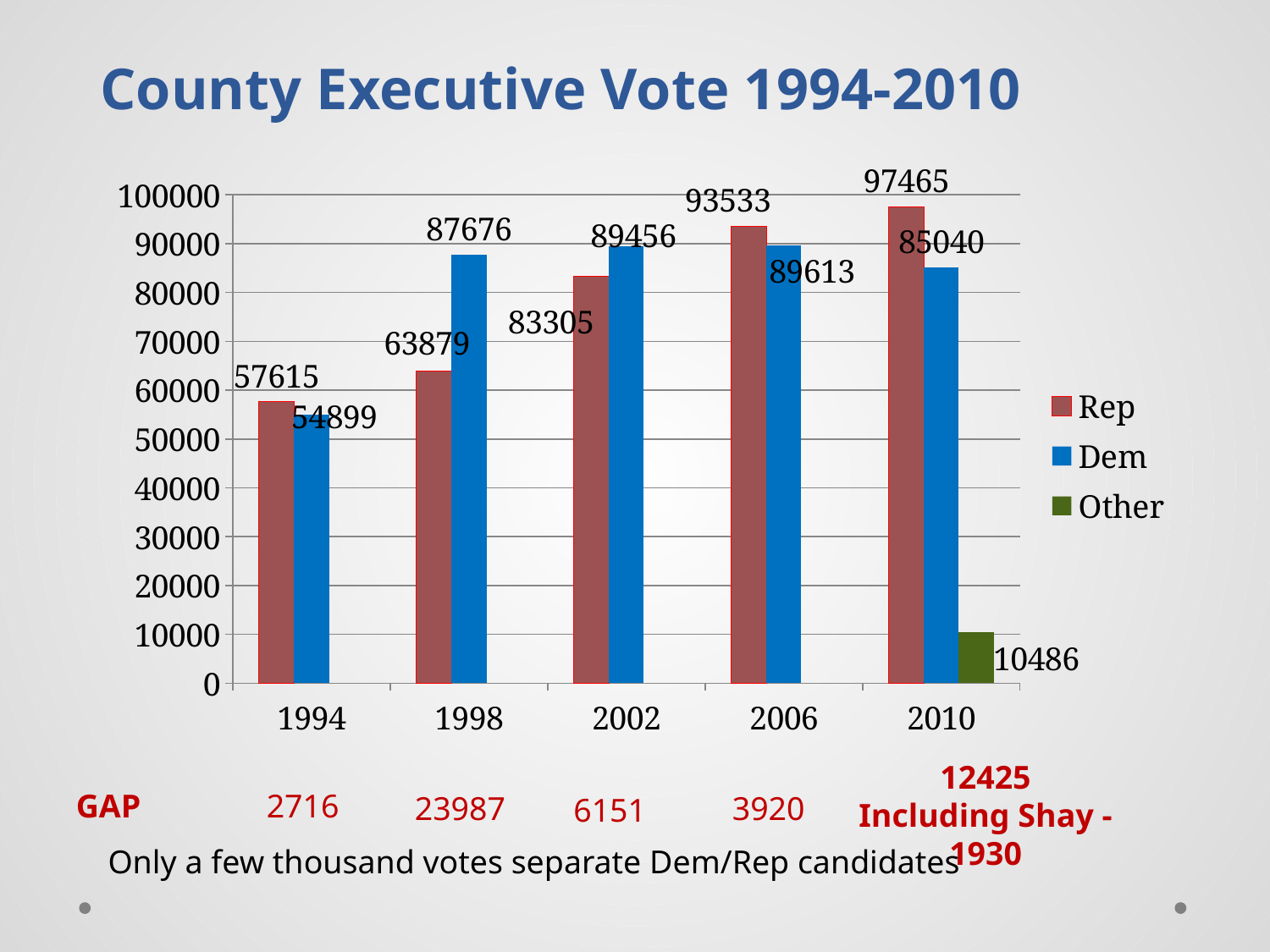
What is the Dem value for 1998? 87676 Which is larger in 1998, the Rep value or the Dem value? Dem What is the Rep value for 2010? 97465 In which year is the Rep value highest? 2010 How many years are shown on the x axis? 5 Do the Rep values rise or fall from 1994 to 2010? rise In which year is the Dem value lowest? 1994 What is the Other value for 2010? 10486 What is the difference between the Rep and Dem values in 2010? 12425 How many series does the legend list? 3 What is the difference between the Rep and Dem values in 2002? 6151 Is the Rep value for 1994 greater or less than 60000? less